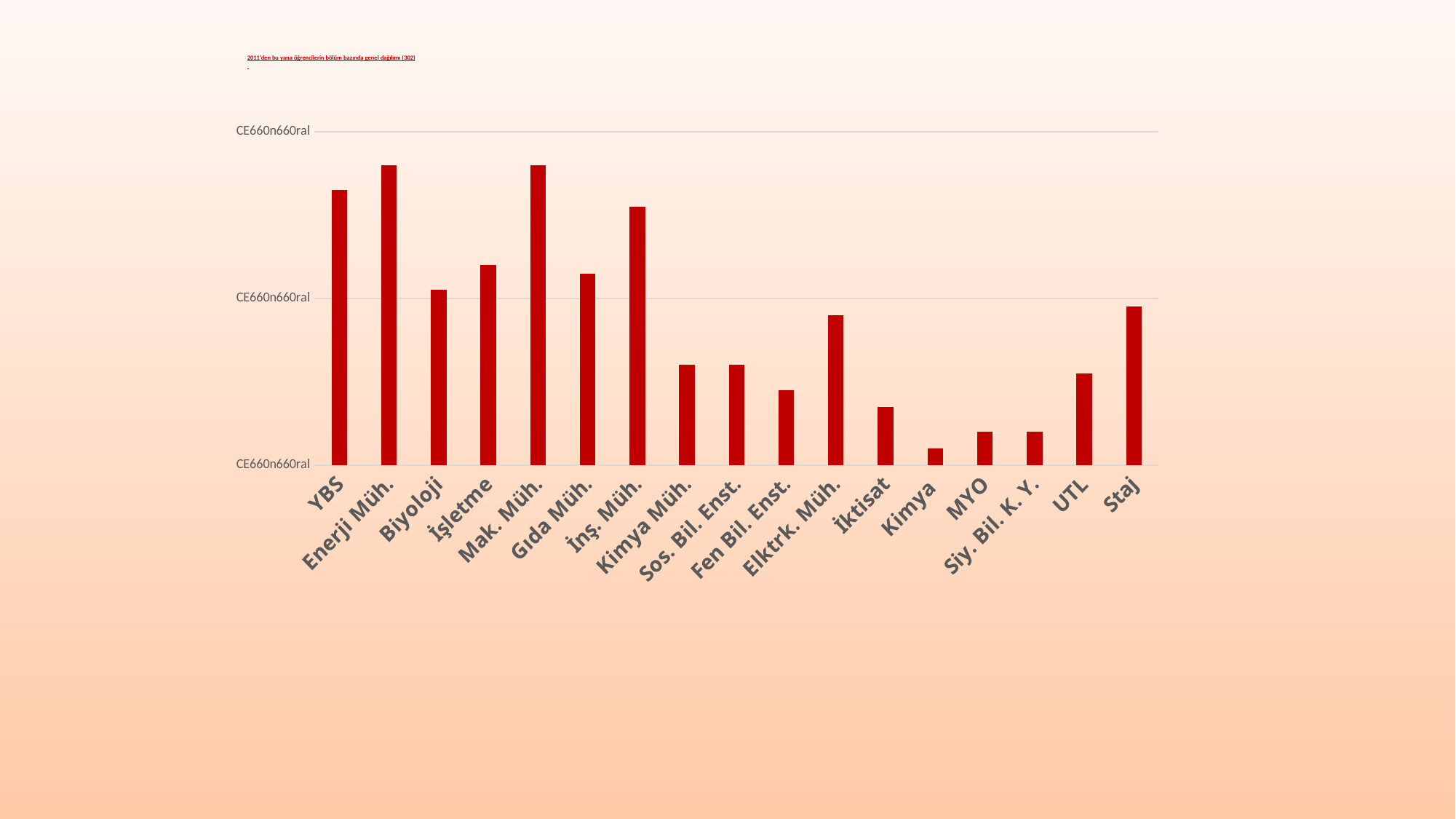
Which is larger, the value for Enerji Müh. or the value for YBS? Enerji Müh. What kind of chart is shown on the slide? bar chart Which is larger, the value for Elktrk. Müh. or the value for İktisat? Elktrk. Müh. How many categories (departments) are shown on the x axis of the chart? 17 Which is larger, the value for Fen Bil. Enst. or the value for İktisat? Fen Bil. Enst. What colour are the bars in the chart? red Which category has the lowest bar in the chart? Kimya Which category is the first one on the left of the x axis? YBS